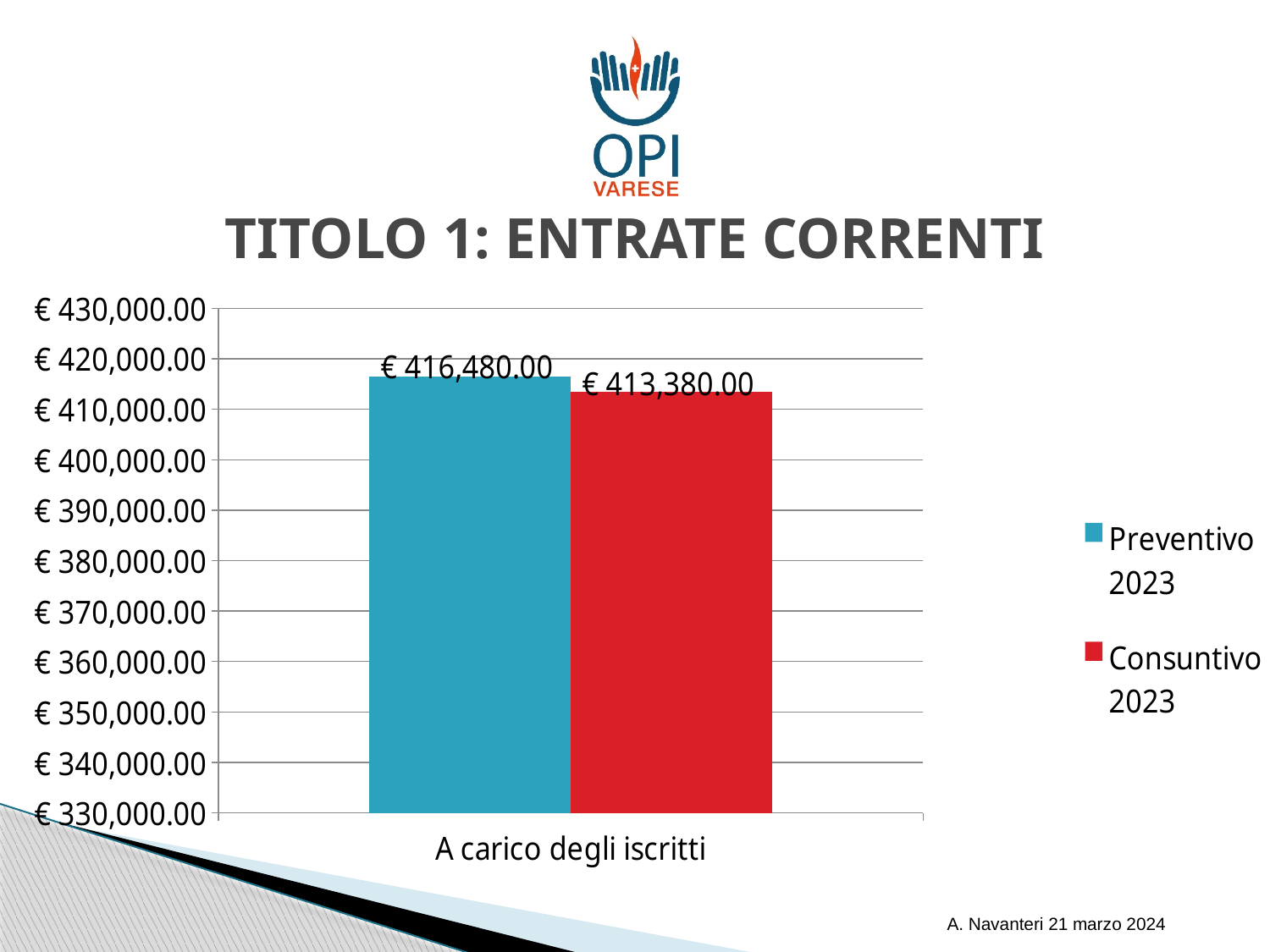
How many series does the legend list? 2 What colour is the bar for Consuntivo 2023? red Is the value for Preventivo 2023 greater or less than € 420,000.00? less Which series has the higher value for A carico degli iscritti, Preventivo 2023 or Consuntivo 2023? Preventivo 2023 How many categories are shown on the x axis? 1 Is the value for Consuntivo 2023 greater or less than € 410,000.00? greater What kind of chart is shown on the slide? bar chart What is the category label on the x axis? A carico degli iscritti What is the value of Consuntivo 2023 for A carico degli iscritti? € 413,380.00 What is the difference between Preventivo 2023 and Consuntivo 2023 for A carico degli iscritti? € 3,100.00 What is the title of the chart? TITOLO 1: ENTRATE CORRENTI What is the value of Preventivo 2023 for A carico degli iscritti? € 416,480.00